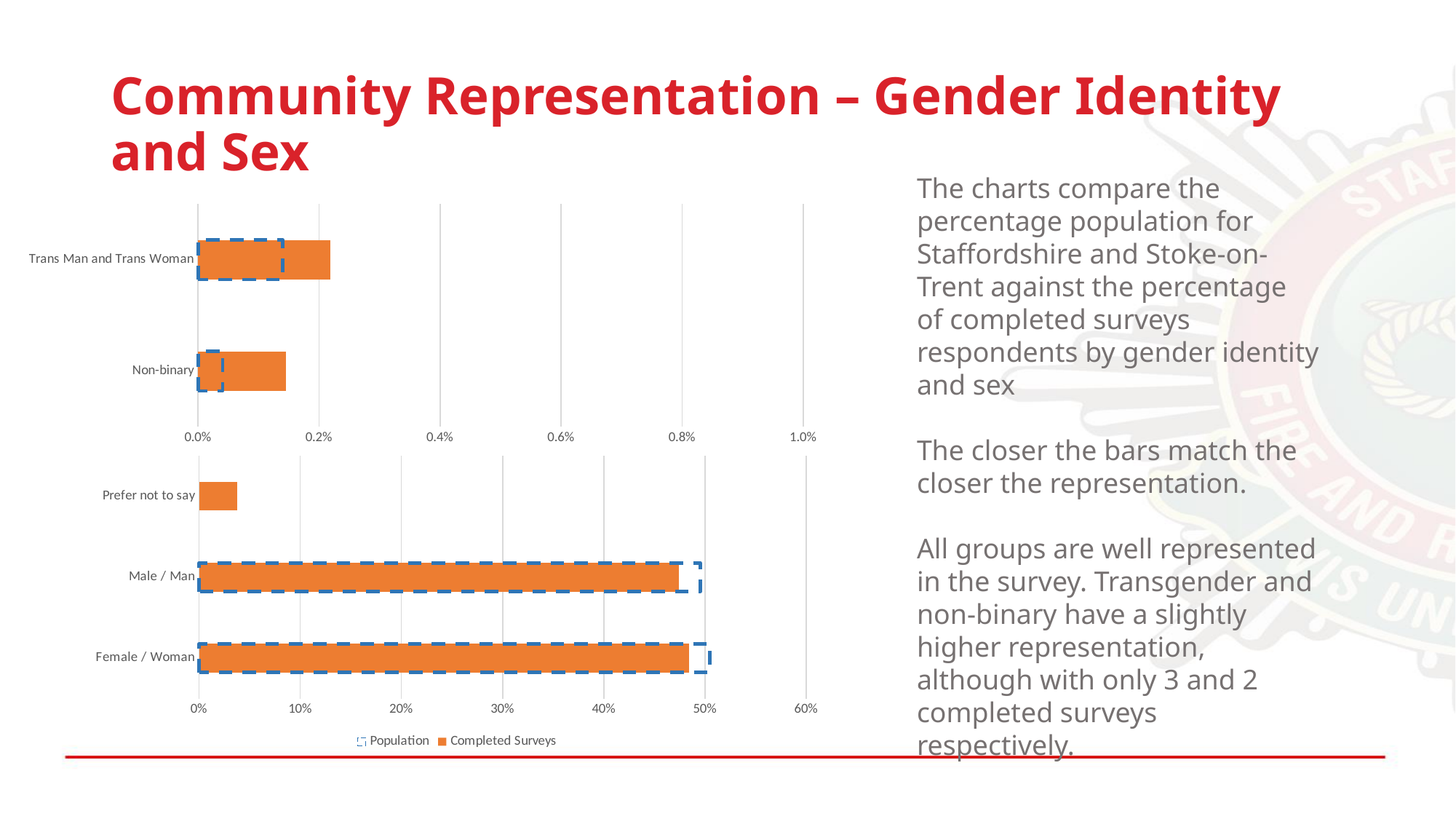
Which series in the legend is drawn as a dashed blue outline? Population In the bottom chart, which category has the lowest Completed Surveys value? Prefer not to say In the bottom chart, is the Completed Surveys value for Prefer not to say greater or less than 10%? less In the top chart, which category has the higher Completed Surveys value, Trans Man and Trans Woman or Non-binary? Trans Man and Trans Woman In the top chart, is the Completed Surveys value for Trans Man and Trans Woman greater or less than 0.4%? less In the bottom chart, for Male / Man, which is larger: the Population value or the Completed Surveys value? Population In the top chart, is the Completed Surveys value for Non-binary greater or less than 0.2%? less In the top chart, for Non-binary, which is larger: the Population value or the Completed Surveys value? Completed Surveys How many series does the legend at the bottom of the slide list? 2 How many categories are shown in the top chart (the one with the 0.0% to 1.0% axis)? 2 What kind of chart is the top chart on the slide? bar chart How many categories are shown in the bottom chart (the one with the 0% to 60% axis)? 3